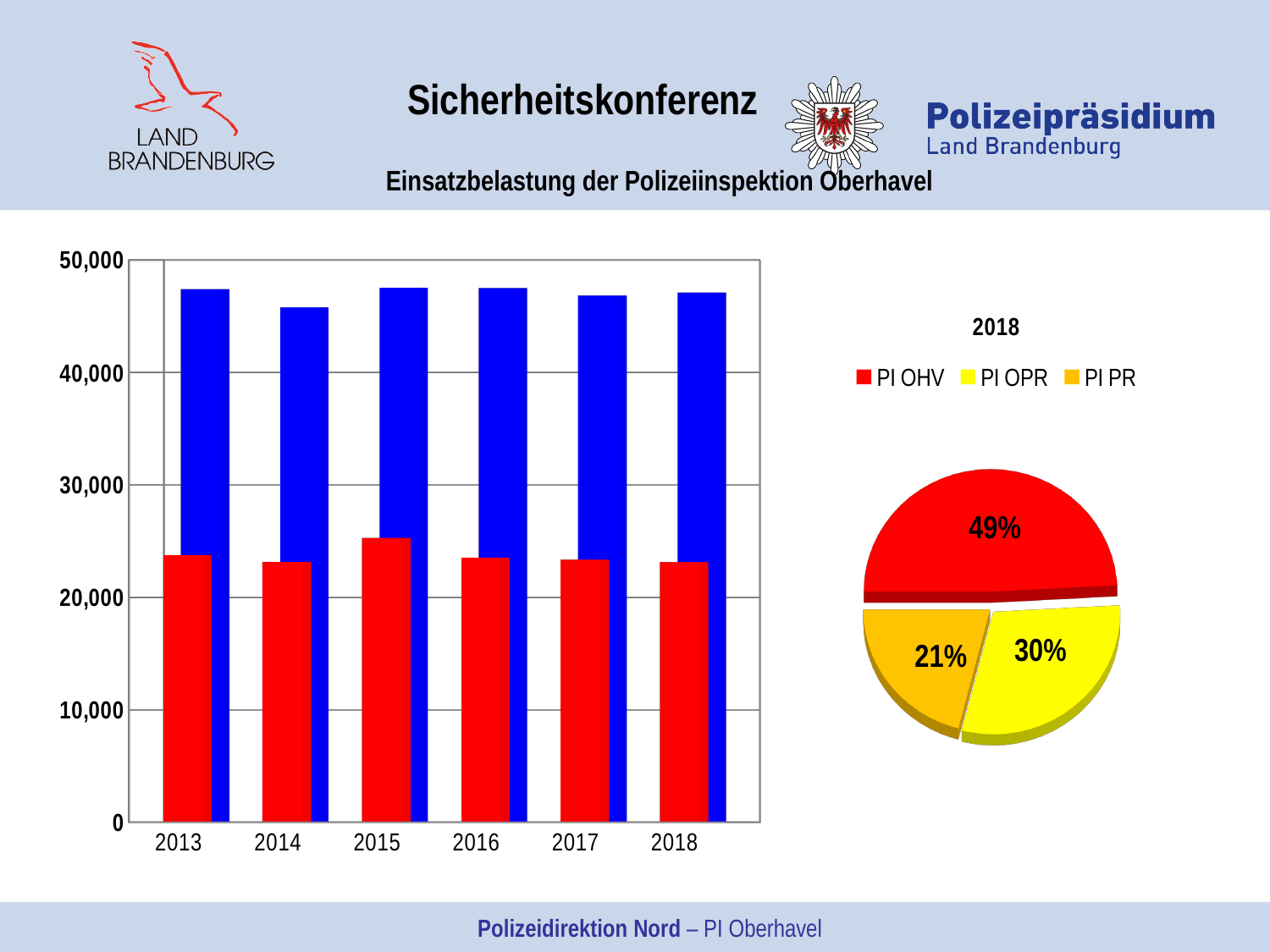
In the bar chart on the left, is the value of the blue bar for 2013 greater or less than 40,000? greater In the pie chart titled 2018, which category has the largest slice? PI OHV In the pie chart titled 2018, which category has the smallest slice? PI PR In the bar chart on the left, how many years are shown on the x axis? 6 In the pie chart titled 2018, what share does PI OHV have? 49% In the bar chart on the left, is the value of the red bar for 2018 greater or less than 30,000? less What kind of chart is the chart on the right side of the slide? pie chart In the pie chart titled 2018, what share does PI OPR have? 30% In the pie chart titled 2018, how many entries does the legend list? 3 In the pie chart titled 2018, what share does PI PR have? 21% What kind of chart is the chart on the left side of the slide? bar chart In the pie chart titled 2018, how many percentage points larger is the PI OHV share than the PI OPR share? 19